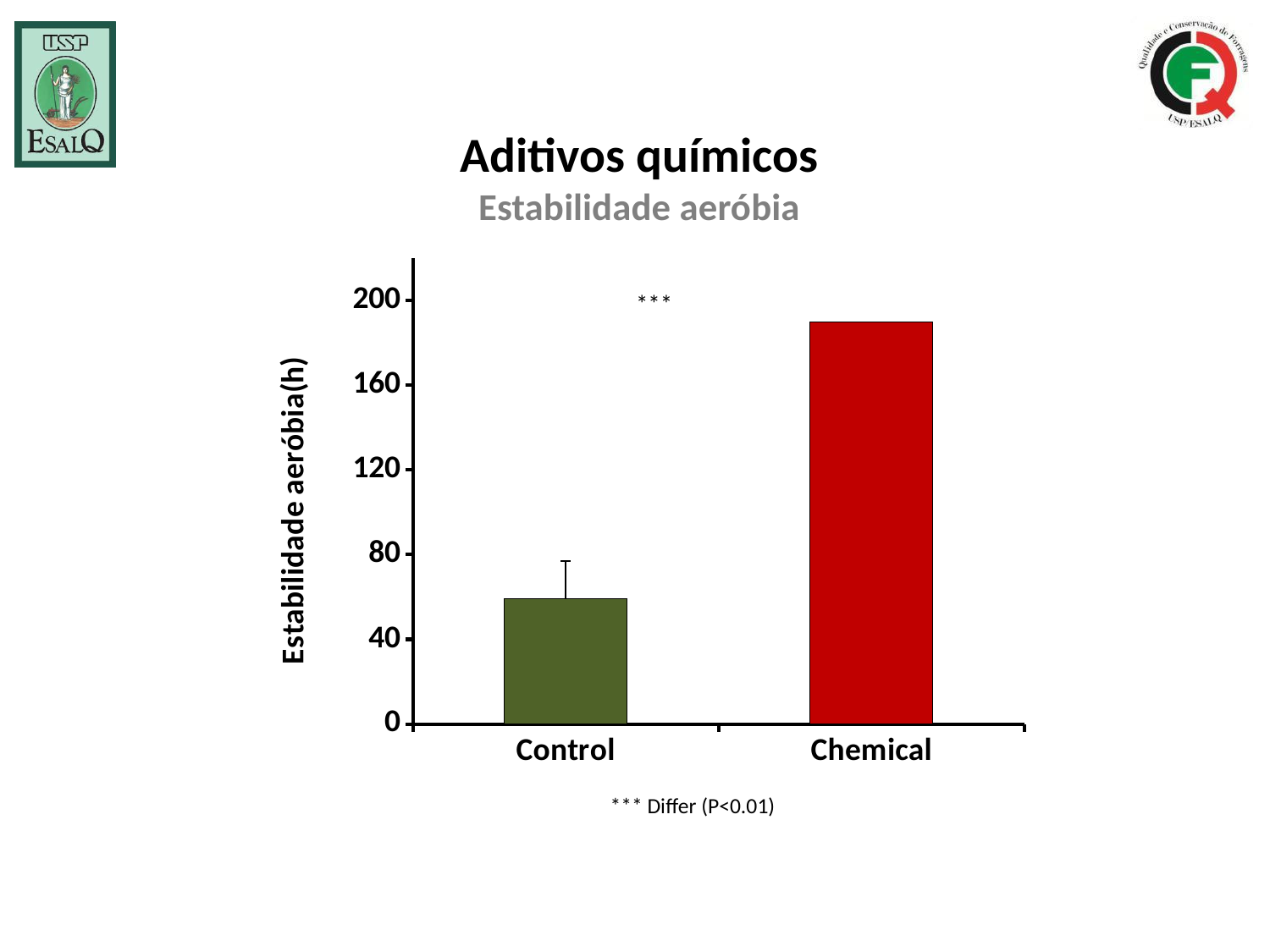
Is the value for Chemical greater or less than 160? greater What colour is the bar for Chemical? red Which is larger, the value for Control or the value for Chemical? Chemical Which category has the highest aerobic stability value? Chemical Is the value for Chemical greater or less than 200? less Is the value for Control greater or less than 40? greater Which category has the lowest aerobic stability value? Control How many categories are plotted on the x axis of the chart? 2 What kind of chart is shown on the slide? bar chart What is the label of the y axis of the chart? Estabilidade aeróbia(h)